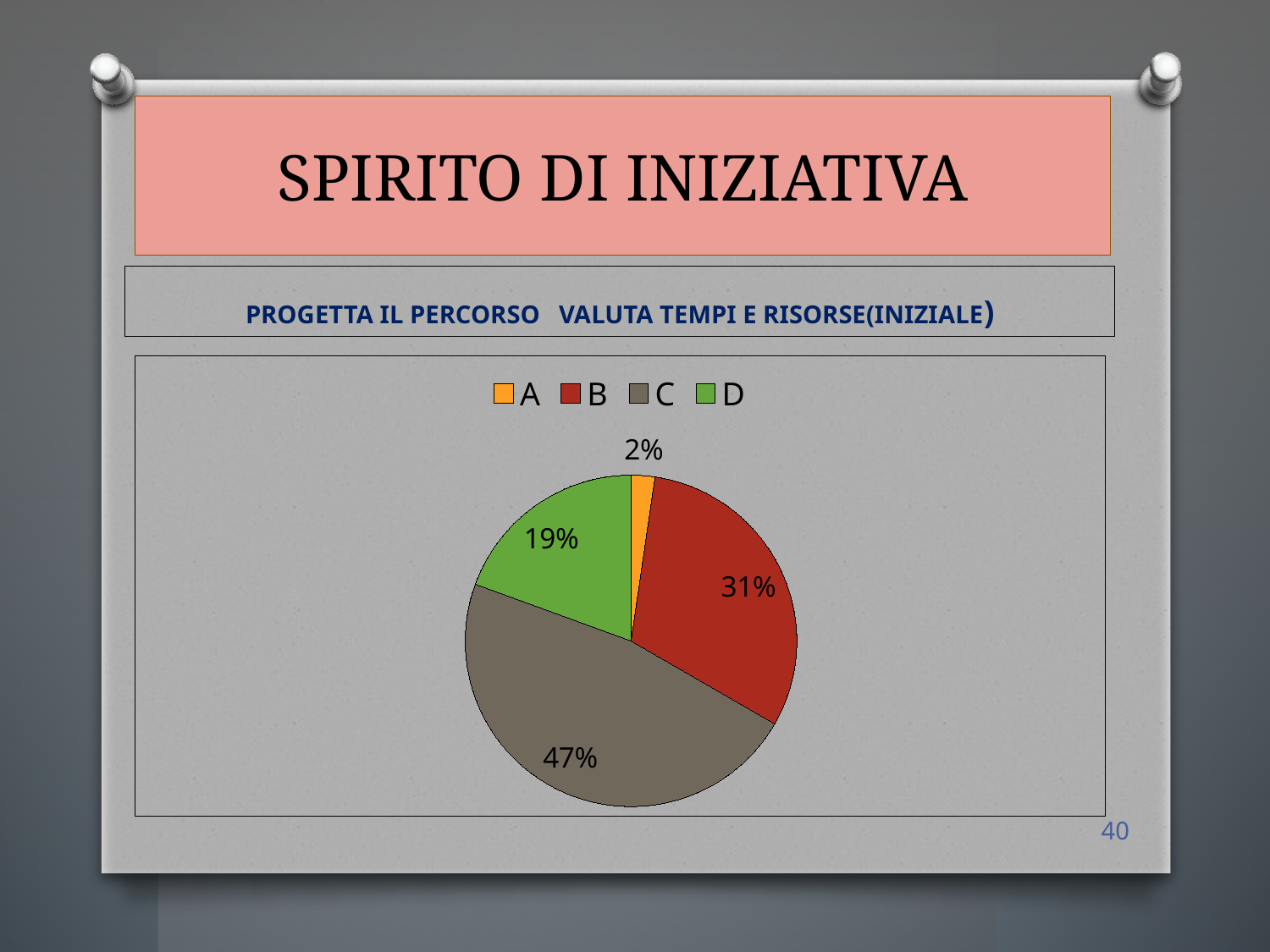
Which is larger, the share for B or the share for D? B What colour is the slice for category D? green Which category has the largest share of the pie? C What is the difference in percentage points between C and B? 16 What percentage does slice C represent? 47% How many categories does the legend list? 4 What percentage does slice A represent? 2% Which category has the smallest share of the pie? A What percentage does slice B represent? 31% What is the difference in percentage points between D and A? 17 What percentage does slice D represent? 19% What kind of chart is shown on the slide? pie chart